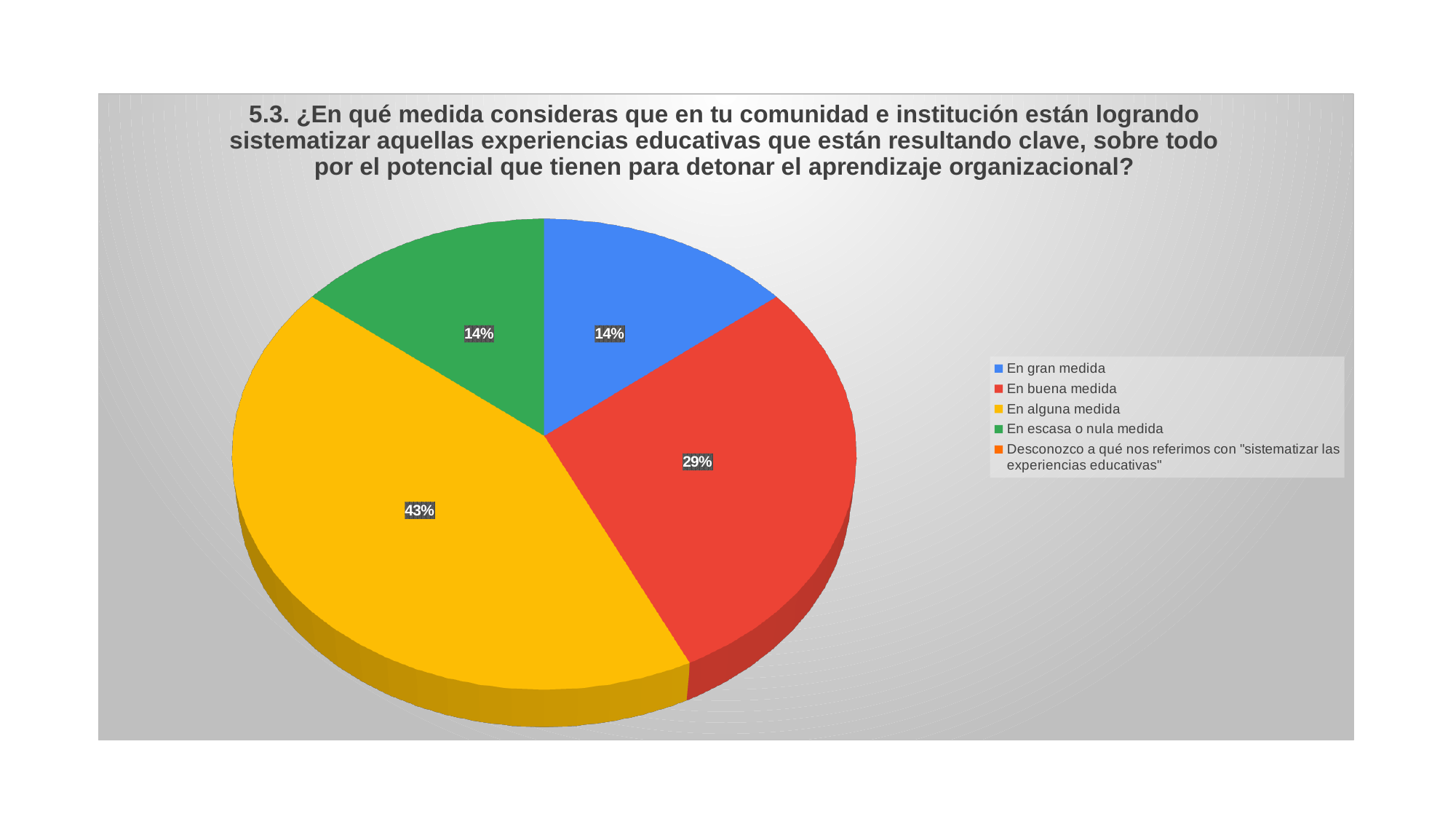
How many entries does the legend list? 5 What share of the pie does "En escasa o nula medida" represent? 14% What share of the pie does "En gran medida" represent? 14% What is the difference in percentage points between "En alguna medida" and "En buena medida"? 14 What share of the pie does "En alguna medida" represent? 43% What share of the pie does "En buena medida" represent? 29% What kind of chart is shown on the slide? pie chart How many slices with a percentage label are visible in the pie? 4 What colour is the slice for "En alguna medida"? yellow Which is larger, the slice for "En buena medida" or the slice for "En gran medida"? En buena medida Which category has the largest slice of the pie? En alguna medida What is the difference in percentage points between "En buena medida" and "En escasa o nula medida"? 15